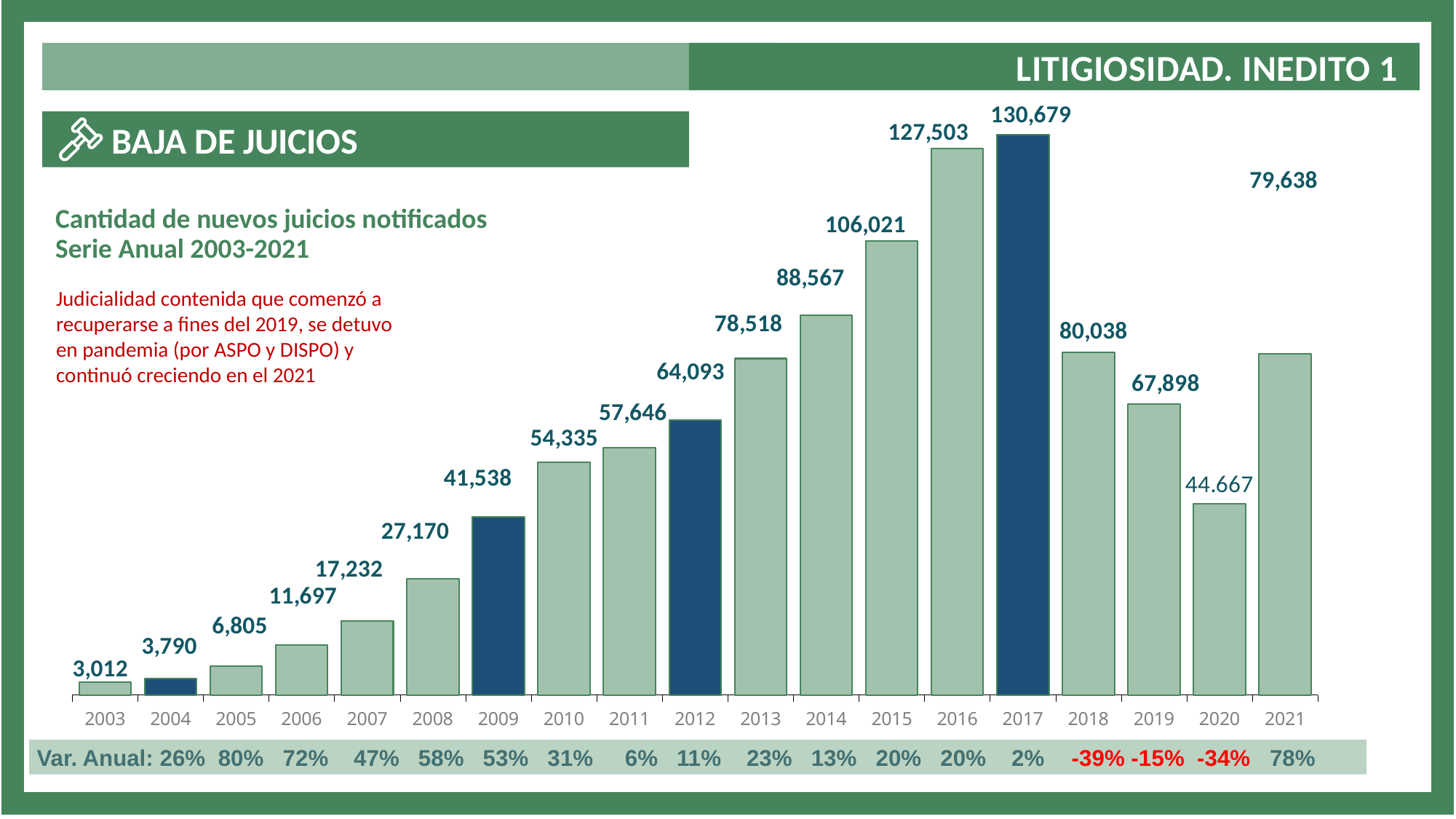
What is the value for 2003? 3,012 What is the value for 2017? 130,679 What is the annual variation (Var. Anual) shown for 2018? -39% Which is larger, the value for 2015 or the value for 2018? 2015 How many years are shown on the x axis? 19 What is the value for 2021? 79,638 What is the difference between the values for 2017 and 2016? 3,176 Which year has the highest value? 2017 What is the difference between the values for 2018 and 2019? 12,140 What is the value for 2012? 64,093 What kind of chart is this? Bar chart Which year has the lowest value? 2003